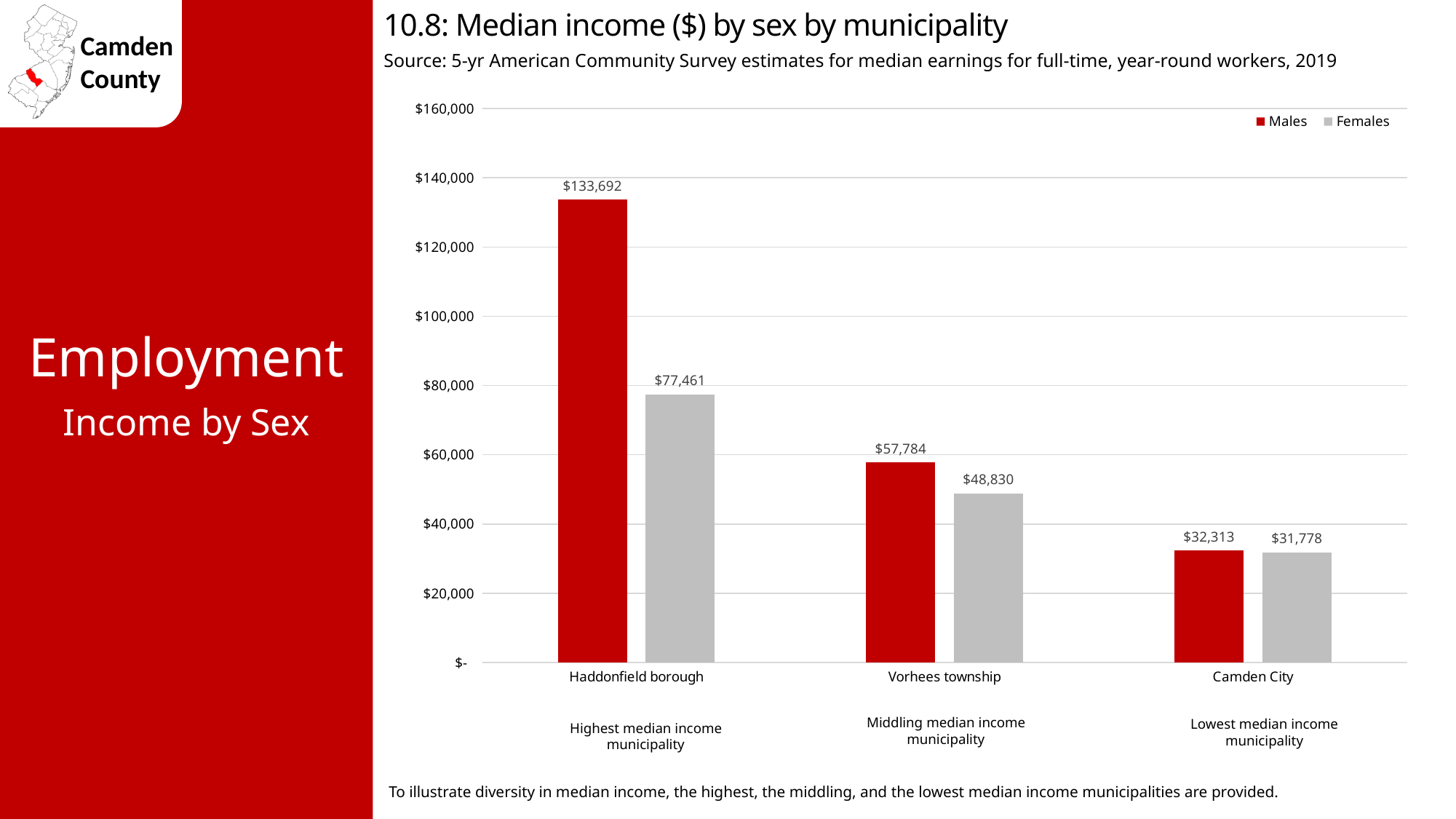
What is the median income for males in Haddonfield borough? $133,692 Which colour represents Males in the chart? Red What is the median income for females in Camden City? $31,778 How many series does the legend list? 2 How many municipalities are shown on the x axis? 3 What is the difference between male and female median income in Haddonfield borough? $56,231 What kind of chart is shown on the slide? Bar chart What is the median income for females in Vorhees township? $48,830 Which municipality has the highest median income for males? Haddonfield borough Which is larger: the female median income in Haddonfield borough or the male median income in Vorhees township? Female median income in Haddonfield borough Which municipality has the lowest median income for females? Camden City What is the difference between male and female median income in Vorhees township? $8,954